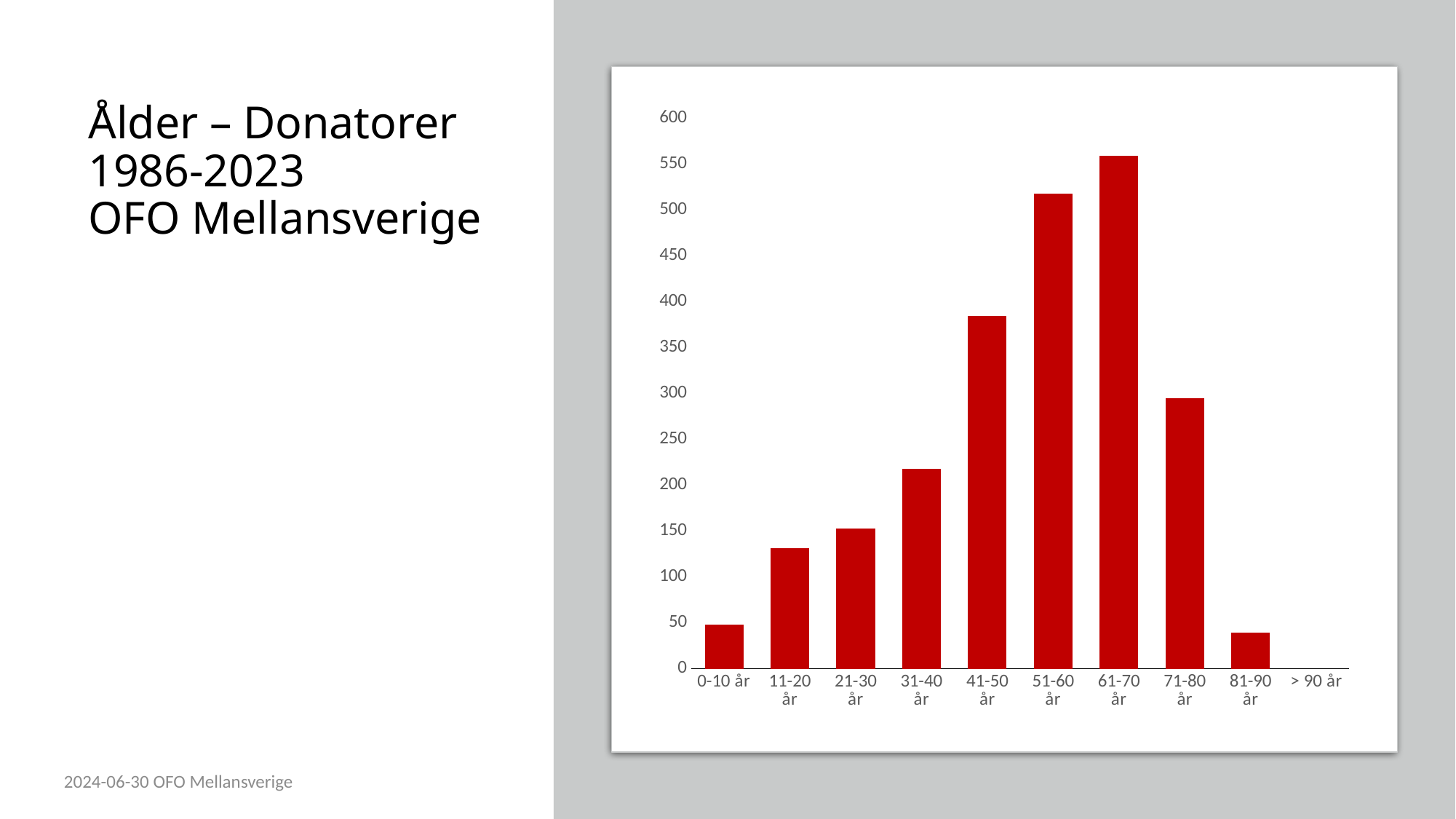
Is the value for 81-90 år greater or less than 50? less How many age groups are shown on the x axis of the chart? 10 What colour are the bars in the chart? Red Is the value for 11-20 år greater or less than 100? greater Is the value for 51-60 år greater or less than 500? greater Which age group has the highest value in the chart? 61-70 år Do the values rise or fall from 0-10 år to 61-70 år? rise What kind of chart is shown on the slide? Bar chart Which is larger, the value for 41-50 år or the value for 71-80 år? 41-50 år